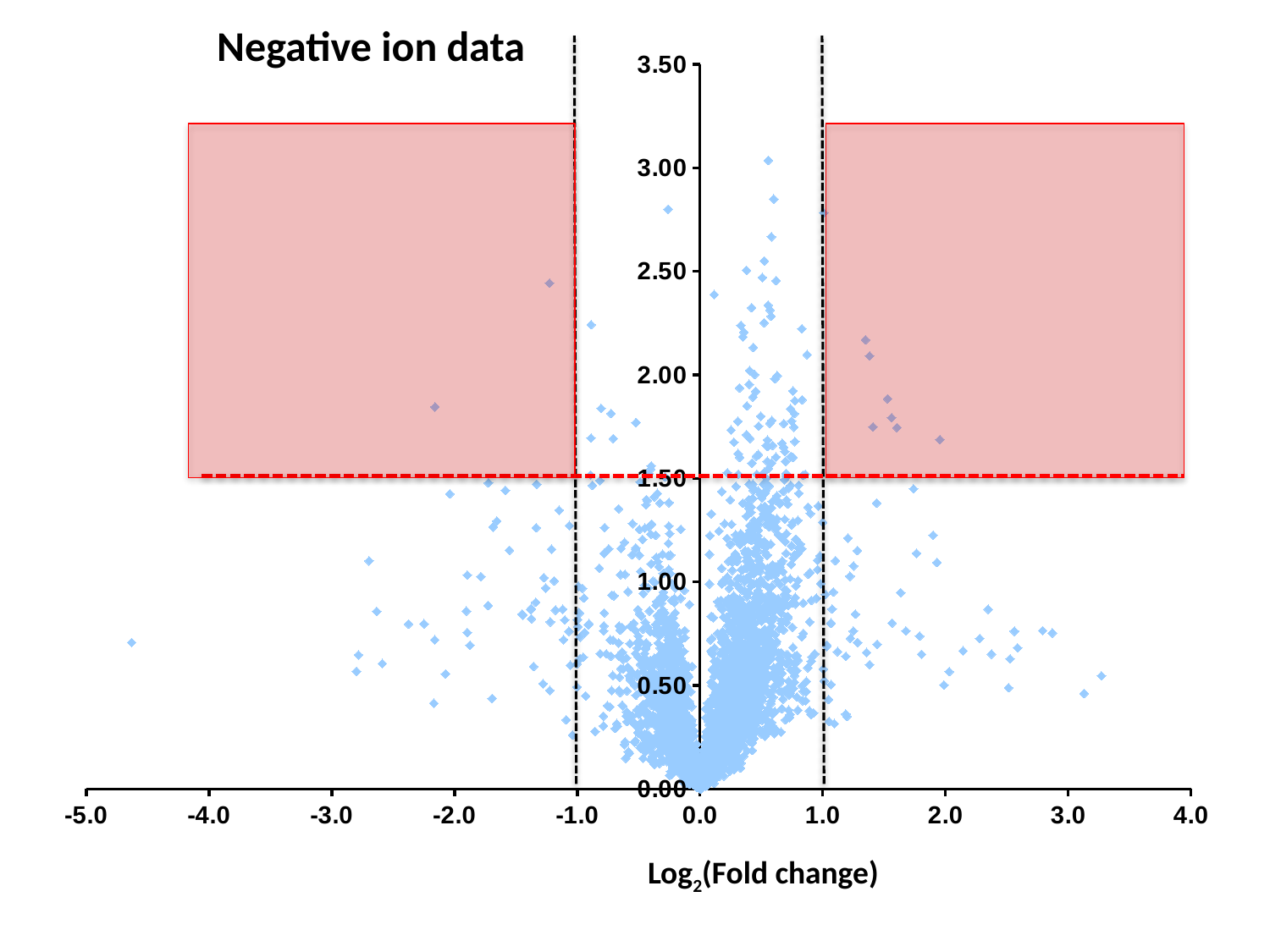
Is the x value of the rightmost point on the chart greater or less than 3.0? greater At which x-axis values are the two vertical black dashed lines drawn? -1.0 and 1.0 What is the maximum value shown on the y axis? 3.50 Is the x value of the leftmost point on the chart greater or less than -4.0? less What is the label of the x axis? Log2(Fold change) What is the minimum value shown on the x axis? -5.0 What kind of chart is shown on the slide? scatter chart What is the maximum value shown on the x axis? 4.0 How many vertical black dashed lines are drawn on the chart? 2 What is the title of the chart? Negative ion data At what y-axis value is the horizontal red dashed line drawn? 1.50 Is the y value of the highest point on the chart greater or less than 2.50? greater